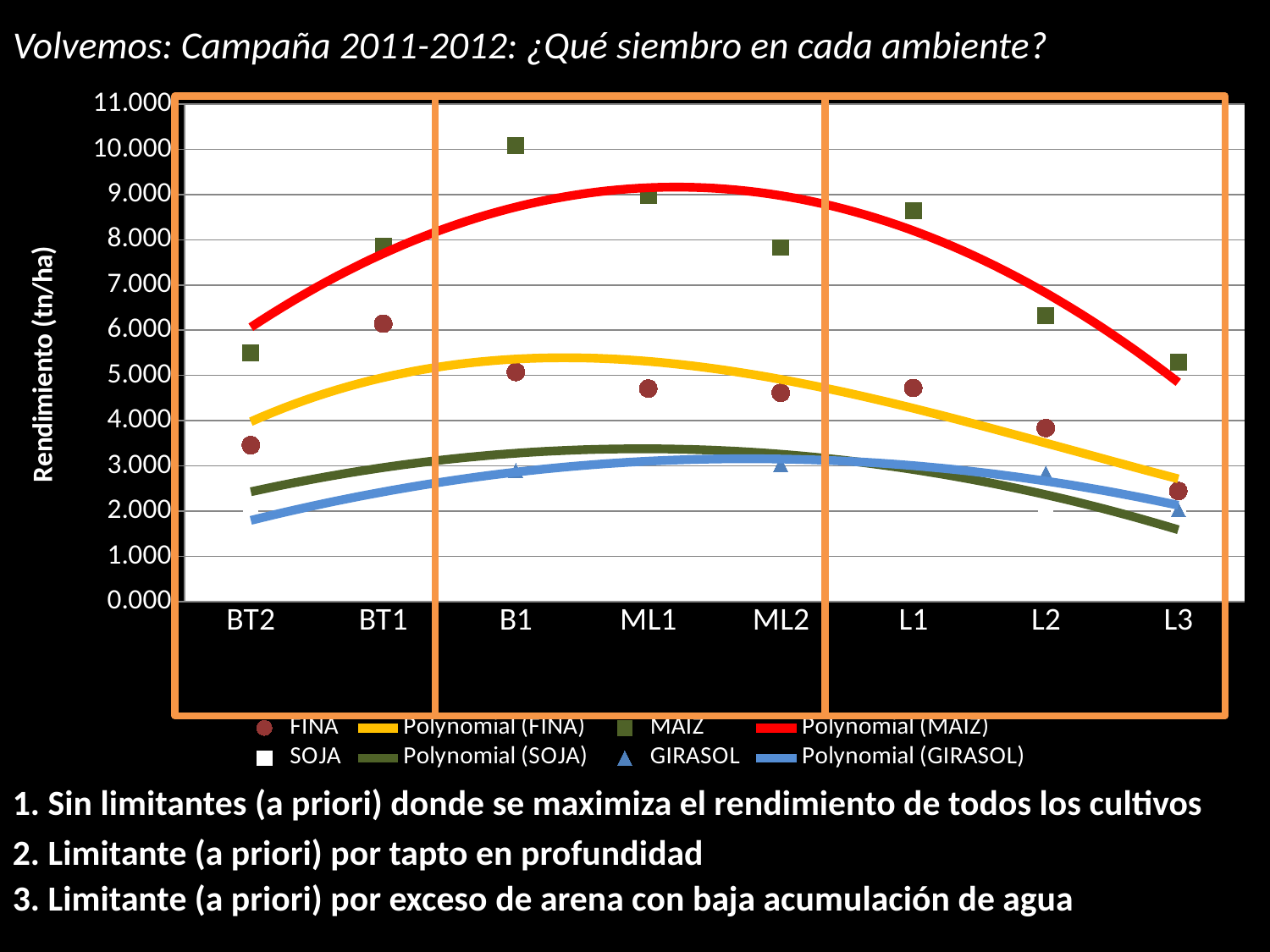
At which category does the FINA series have its lowest value? L3 What is the title of the y axis? Rendimiento (tn/ha) At B1, which series has the larger value, MAIZ or FINA? MAIZ How many entries does the legend list? 8 Is the FINA value at L3 greater or less than 3.000? less Is the MAIZ value at L3 greater or less than 5.000? greater How many categories are shown on the x axis? 8 What kind of chart is shown on the slide? Scatter chart with polynomial trendlines Is the MAIZ value at B1 greater or less than 9.000? greater At which category does the MAIZ series reach its highest value? B1 Which series is represented by the red trendline? Polynomial (MAIZ)